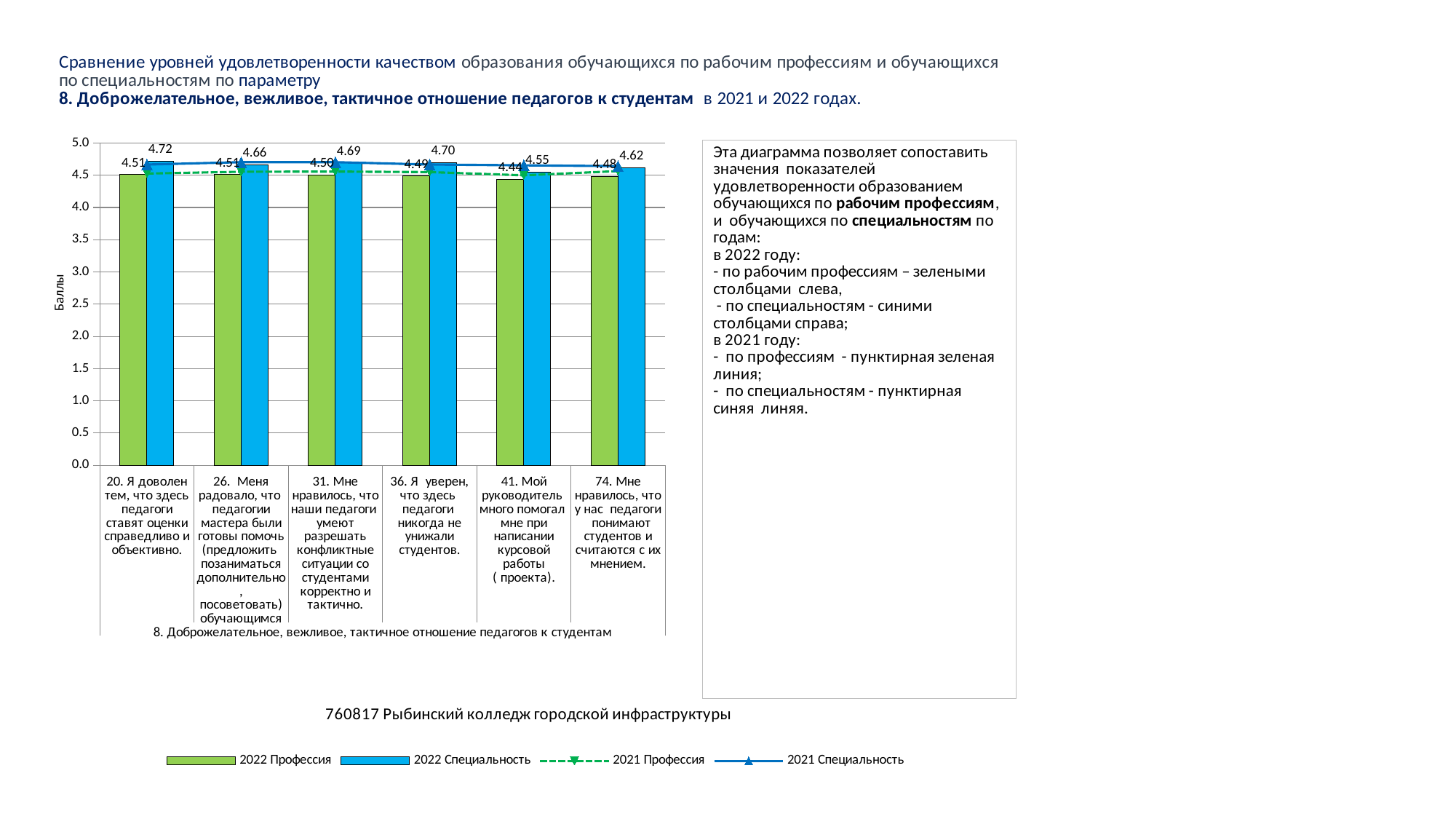
Which category has the lowest 2022 Профессия value? 41. Мой руководитель много помогал мне при написании курсовой работы (проекта). Which category has the highest 2022 Специальность value? 20. Я доволен тем, что здесь педагоги ставят оценки справедливо и объективно. How many categories (questions) are shown on the x axis of the chart? 6 What is the value of the 2022 Специальность bar for category 20 (Я доволен тем, что здесь педагоги ставят оценки справедливо и объективно)? 4.72 For category 26 (Меня радовало, что педагогии мастера были готовы помочь), which is larger: the 2022 Профессия bar or the 2022 Специальность bar? 2022 Специальность What is the value of the 2022 Специальность bar for category 74 (Мне нравилось, что у нас педагоги понимают студентов и считаются с их мнением)? 4.62 What is the difference between the 2022 Специальность and 2022 Профессия values for category 36 (Я уверен, что здесь педагоги никогда не унижали студентов)? 0.21 What is the label of the y axis of the chart? Баллы What is the value of the 2022 Профессия bar for category 41 (Мой руководитель много помогал мне при написании курсовой работы)? 4.44 Is the 2022 Профессия value for category 41 greater or less than 4.5? less What kind of chart is shown on the slide? Combined bar and line chart How many series does the chart legend list? 4